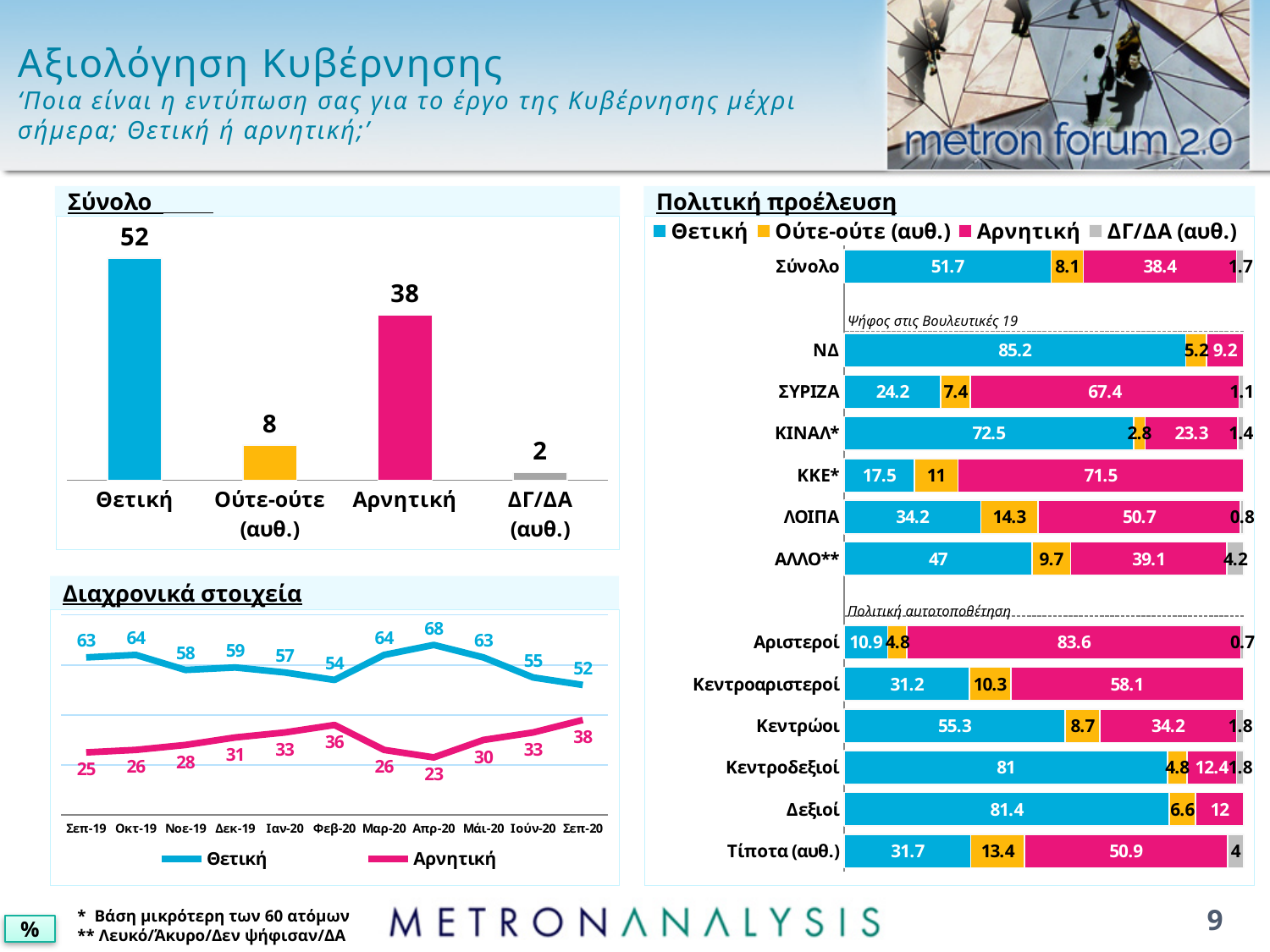
In the 'Πολιτική προέλευση' chart, which category has the highest Θετική value? ΝΔ In the 'Σύνολο' chart, what is the difference between Θετική and Αρνητική? 14 In the 'Διαχρονικά στοιχεία' chart, what is the Αρνητική value for Σεπ-20? 38 In the 'Σύνολο' chart, what is the value for Θετική? 52 In the 'Διαχρονικά στοιχεία' chart, how many series does the legend list? 2 In the 'Διαχρονικά στοιχεία' chart, what is the Θετική value for Απρ-20? 68 In the 'Σύνολο' chart, which category has the lowest value? ΔΓ/ΔΑ (αυθ.) What type of chart is the 'Πολιτική προέλευση' chart? stacked bar chart In the 'Πολιτική προέλευση' chart, which is larger: the Θετική value for Κεντρώοι or for Κεντροαριστεροί? Κεντρώοι In the 'Σύνολο' chart, how many categories are shown? 4 In the 'Διαχρονικά στοιχεία' chart, does the Θετική series rise or fall from Απρ-20 to Σεπ-20? fall In the 'Πολιτική προέλευση' chart, what is the Αρνητική value for ΣΥΡΙΖΑ? 67.4